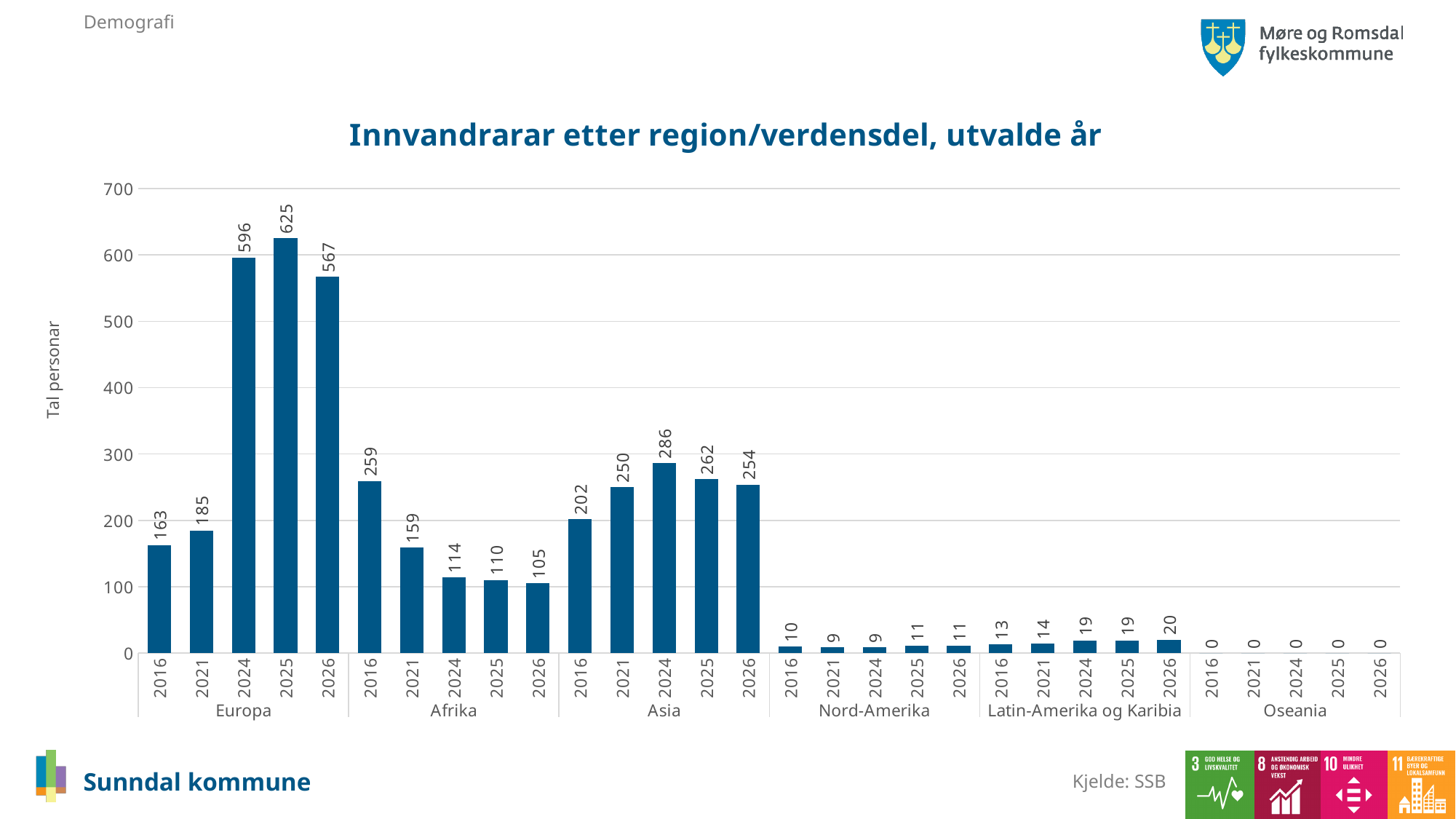
What is the value for Europa in 2025? 625 What is the value for Asia in 2024? 286 What is the title of the chart? Innvandrarar etter region/verdensdel, utvalde år What is the difference between the Asia values for 2016 and 2021? 48 Do the values for Afrika rise or fall from 2016 to 2026? Fall How many regions are shown on the x axis? 6 What is the value for Latin-Amerika og Karibia in 2026? 20 What kind of chart is this? Bar chart What is the value for Afrika in 2016? 259 What is the difference between the Europa values for 2025 and 2026? 58 Which is larger, the value for Afrika in 2021 or the value for Europa in 2021? Europa in 2021 Which region and year has the highest bar in the chart? Europa, 2025